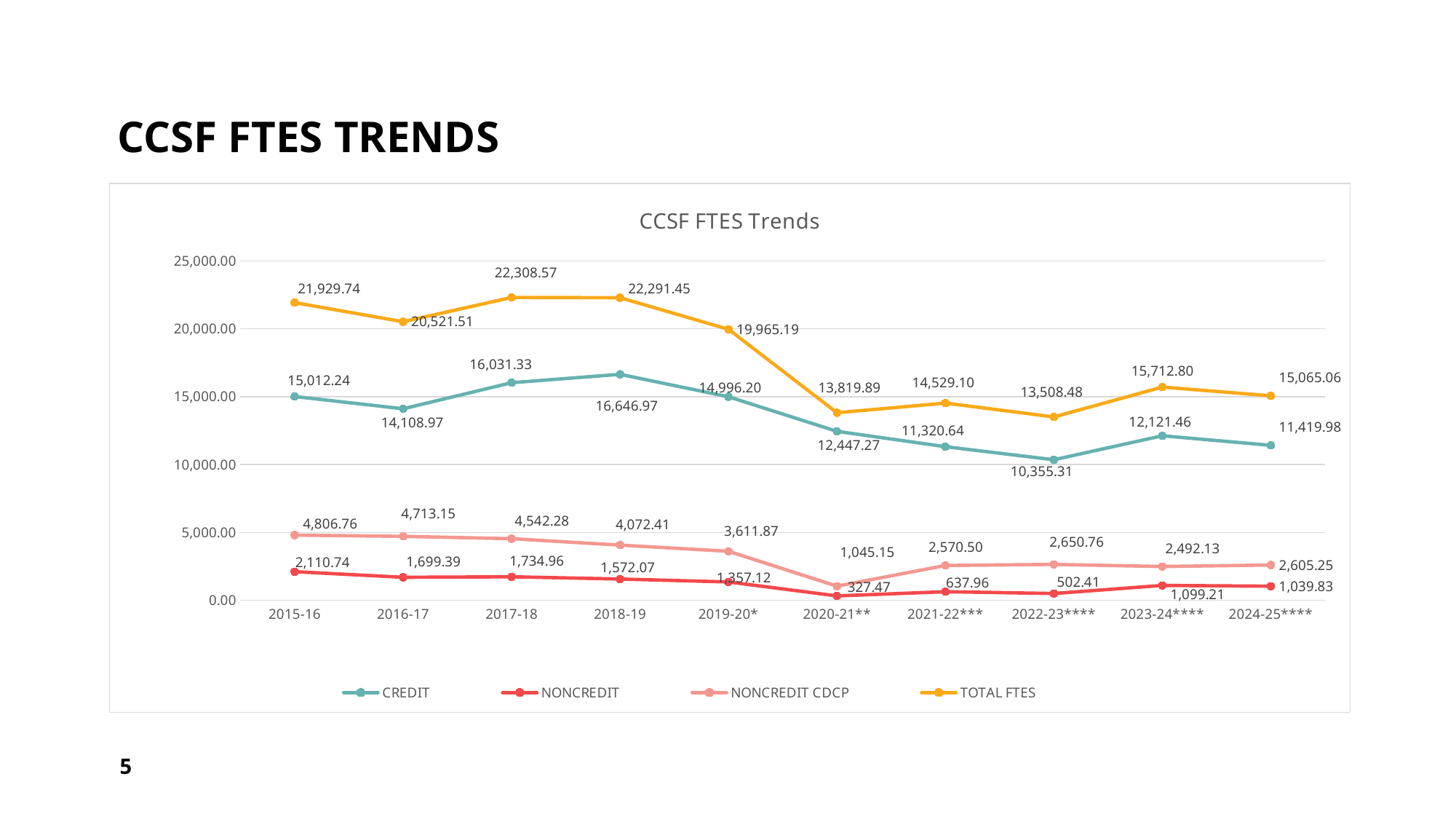
What is the NONCREDIT CDCP value for 2019-20*? 3,611.87 What is the difference between the TOTAL FTES values for 2017-18 and 2016-17? 1,787.06 What is the CREDIT value for 2020-21**? 12,447.27 What type of chart is shown on the slide? Line chart What is the NONCREDIT value for 2024-25****? 1,039.83 What is the TOTAL FTES value for 2017-18? 22,308.57 Which is larger, the NONCREDIT CDCP value for 2021-22*** or for 2022-23****? 2022-23**** How many academic years are plotted on the x axis? 10 In which year is the TOTAL FTES series at its highest? 2017-18 Does the TOTAL FTES series generally rise or fall from 2015-16 to 2024-25****? Fall How many series does the legend list? 4 In which year is the CREDIT series at its lowest? 2022-23****